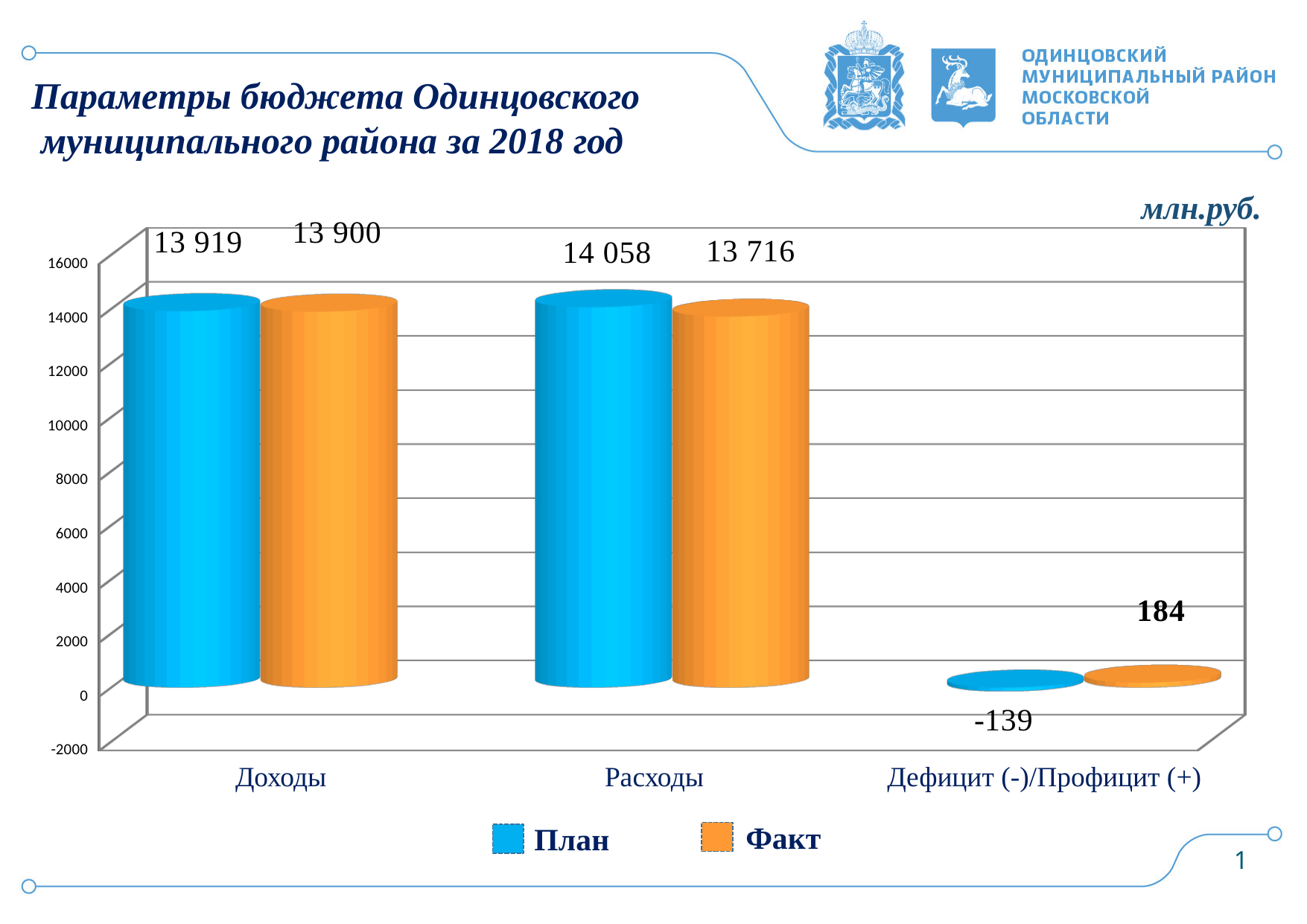
What is the План value for Доходы? 13 919 What is the Факт value for Расходы? 13 716 What kind of chart is shown on the slide? Bar chart Which category has the lowest Факт value? Дефицит (-)/Профицит (+) What is the План value for Дефицит (-)/Профицит (+)? -139 Which category has the highest План value? Расходы What is the Факт value for Дефицит (-)/Профицит (+)? 184 How many categories are shown on the x axis? 3 What unit is indicated above the chart? млн.руб. What is the difference between the План and Факт values for Расходы? 342 Which is larger for Доходы, the План value or the Факт value? План How many series does the legend list? 2